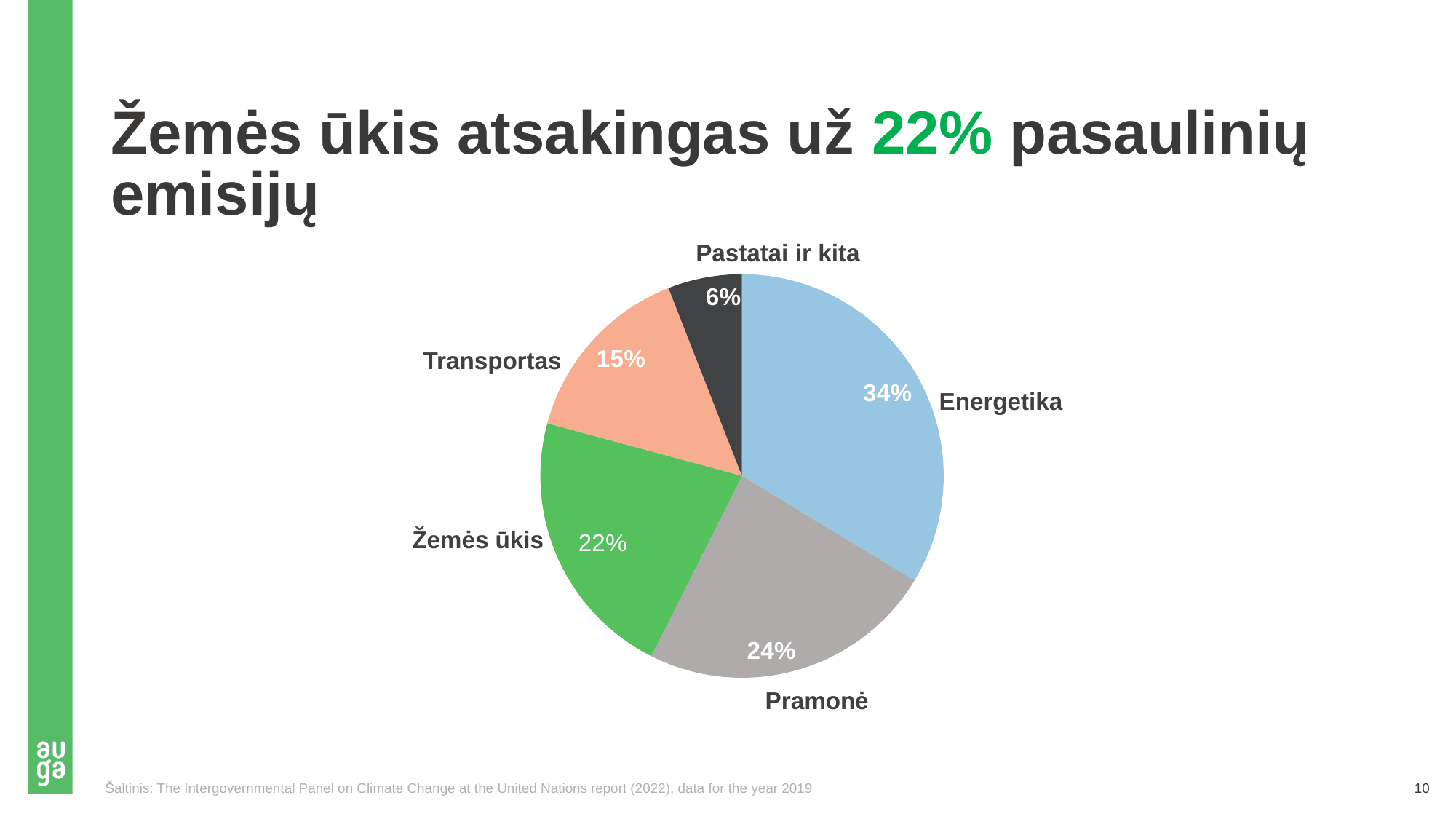
What colour is the Žemės ūkis slice? green Which is larger, Pramonė or Transportas? Pramonė Which category has the largest slice of the pie? Energetika How many categories are shown in the pie chart? 5 What is the value shown for Pramonė? 24% Which category has the smallest slice of the pie? Pastatai ir kita What is the difference between the Energetika and Žemės ūkis shares? 12% What is the value shown for Žemės ūkis? 22% What is the value for Pastatai ir kita? 6% What share of global emissions does Energetika account for? 34% What percentage is shown for Transportas? 15% What type of chart is shown on the slide? pie chart